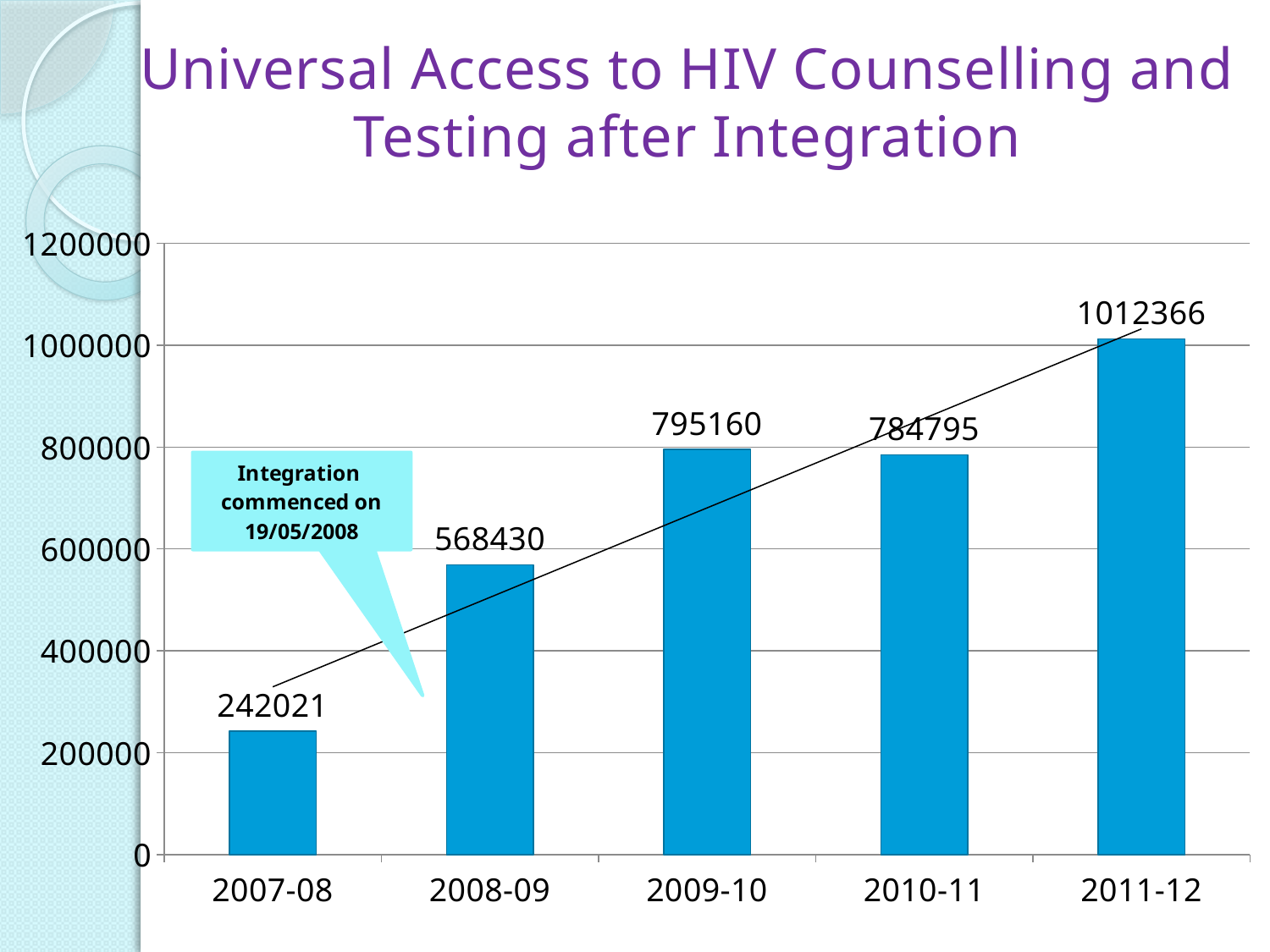
According to the callout on the chart, on what date did integration commence? 19/05/2008 Which is larger, the value for 2008-09 or the value for 2010-11? 2010-11 What is the value for 2011-12? 1012366 Which year has the highest value? 2011-12 What is the difference between the values for 2011-12 and 2007-08? 770345 Which year has the lowest value? 2007-08 What is the value for 2007-08? 242021 Is the value for 2008-09 greater or less than 600000? less What is the value for 2009-10? 795160 What kind of chart is shown on the slide? bar chart What is the difference between the values for 2009-10 and 2010-11? 10365 How many years are shown on the x axis? 5